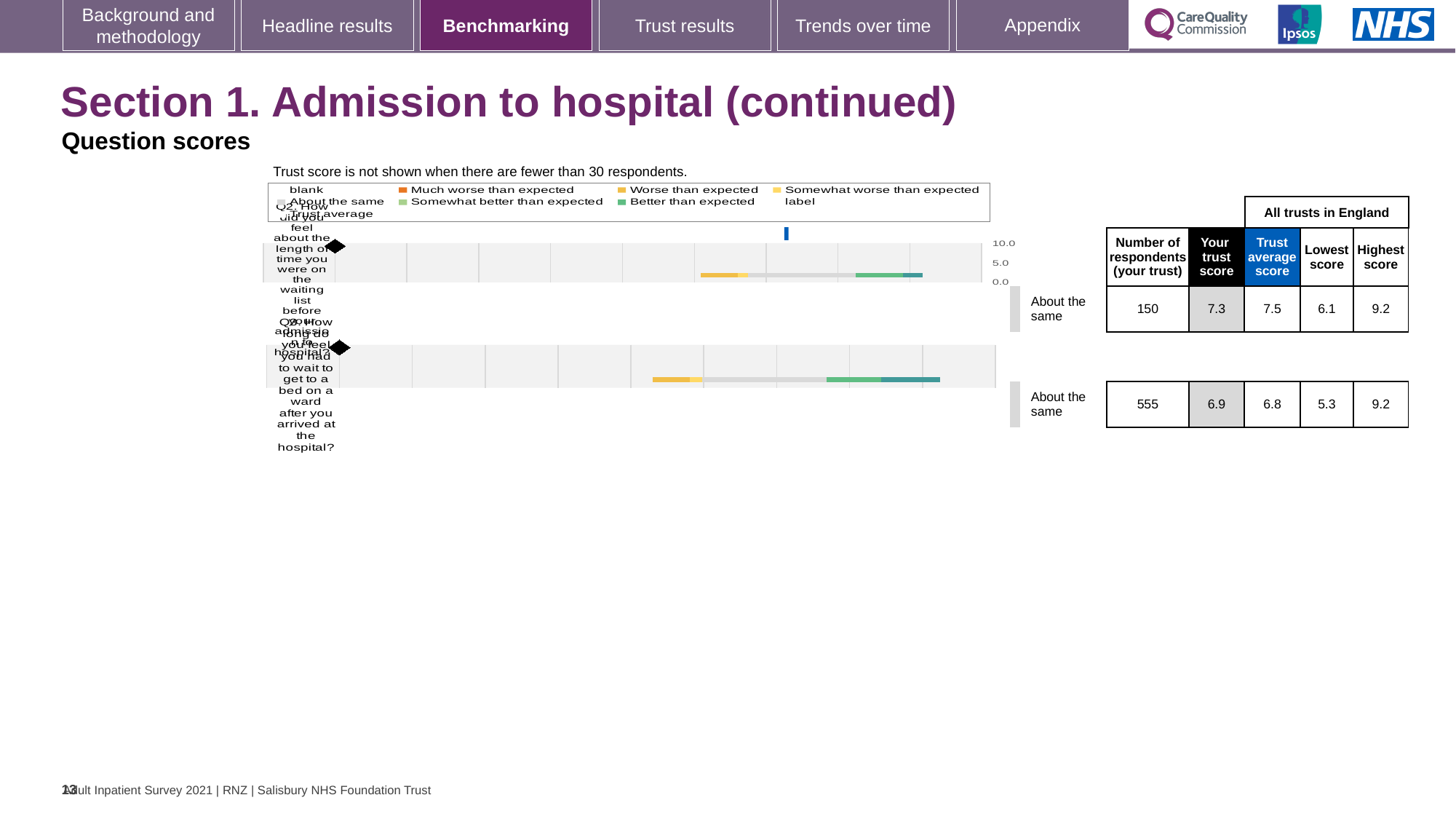
Which question has the higher trust score, Q2 or Q3? Q2 What kind of chart is used to show the question scores on this slide? bar chart How many survey questions are plotted in the question scores chart? 2 What is the trust score for Q2 (how did you feel about the length of time you were on the waiting list before admission)? 7.3 How is this trust's score for Q3 categorised relative to expectations? About the same Which question has the lower 'Lowest score' across all trusts in England, Q2 or Q3? Q3 Which legend entry is shown in orange in the chart legend? Much worse than expected What is the trust average score across all trusts in England for Q2? 7.5 What is the trust score for Q3 (how long did you feel you had to wait to get to a bed on a ward)? 6.9 How many respondents answered Q3 at this trust? 555 What is the difference between the trust average score and this trust's score for Q2? 0.2 What is the highest value shown on the chart's score axis? 10.0